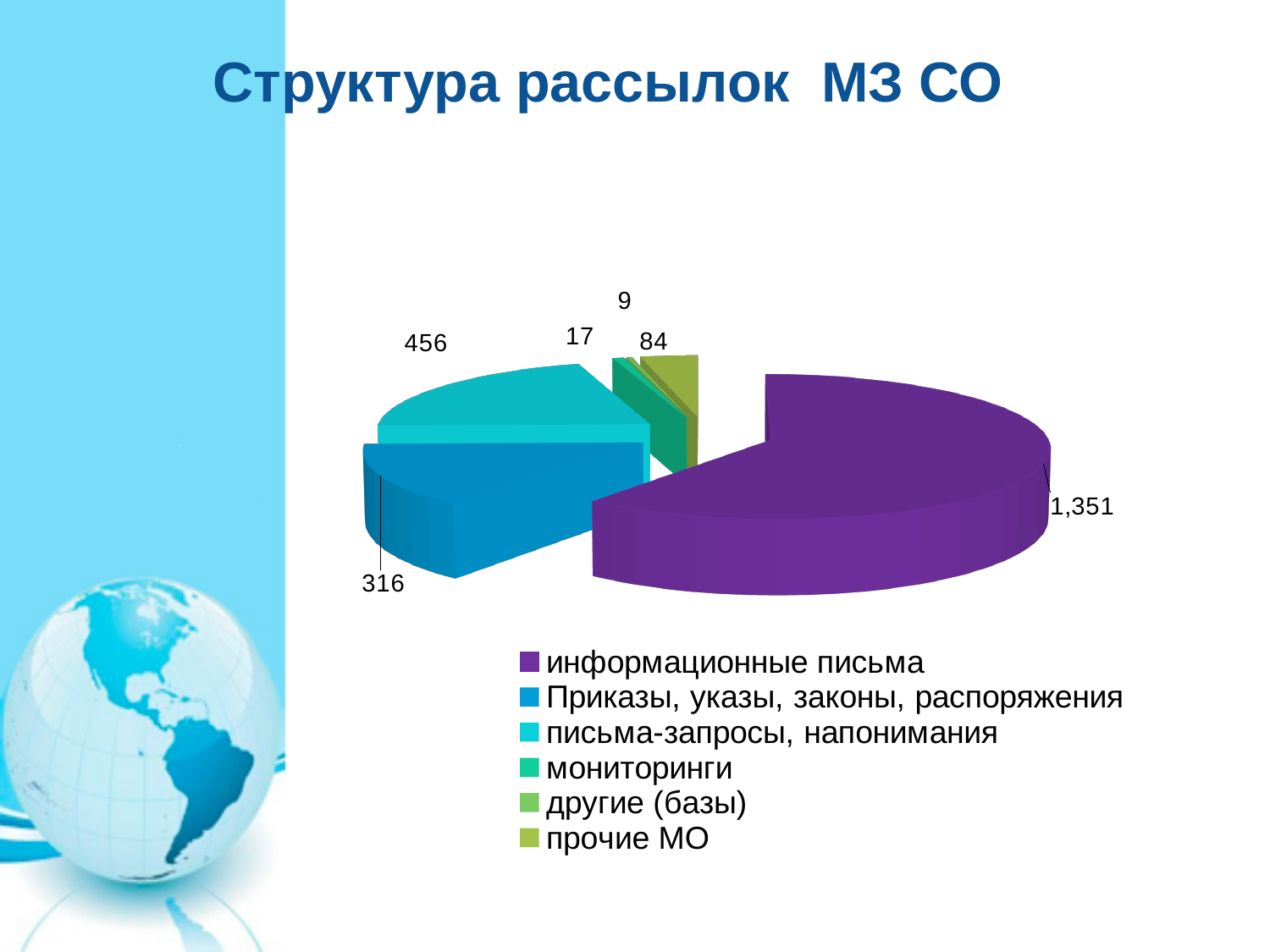
What is the title of the chart slide? Структура рассылок МЗ СО Which is larger: the value for прочие МО or the value for мониторинги? прочие МО What is the value for Приказы, указы, законы, распоряжения? 316 What is the value for информационные письма? 1,351 What kind of chart is shown on the slide? pie chart Which category has the largest slice of the pie? информационные письма What is the value for прочие МО? 84 What is the value for письма-запросы, напонимания? 456 Which category has the smallest slice of the pie? другие (базы) How many categories does the legend list? 6 What is the value for мониторинги? 17 What is the difference between the values for письма-запросы, напонимания and Приказы, указы, законы, распоряжения? 140